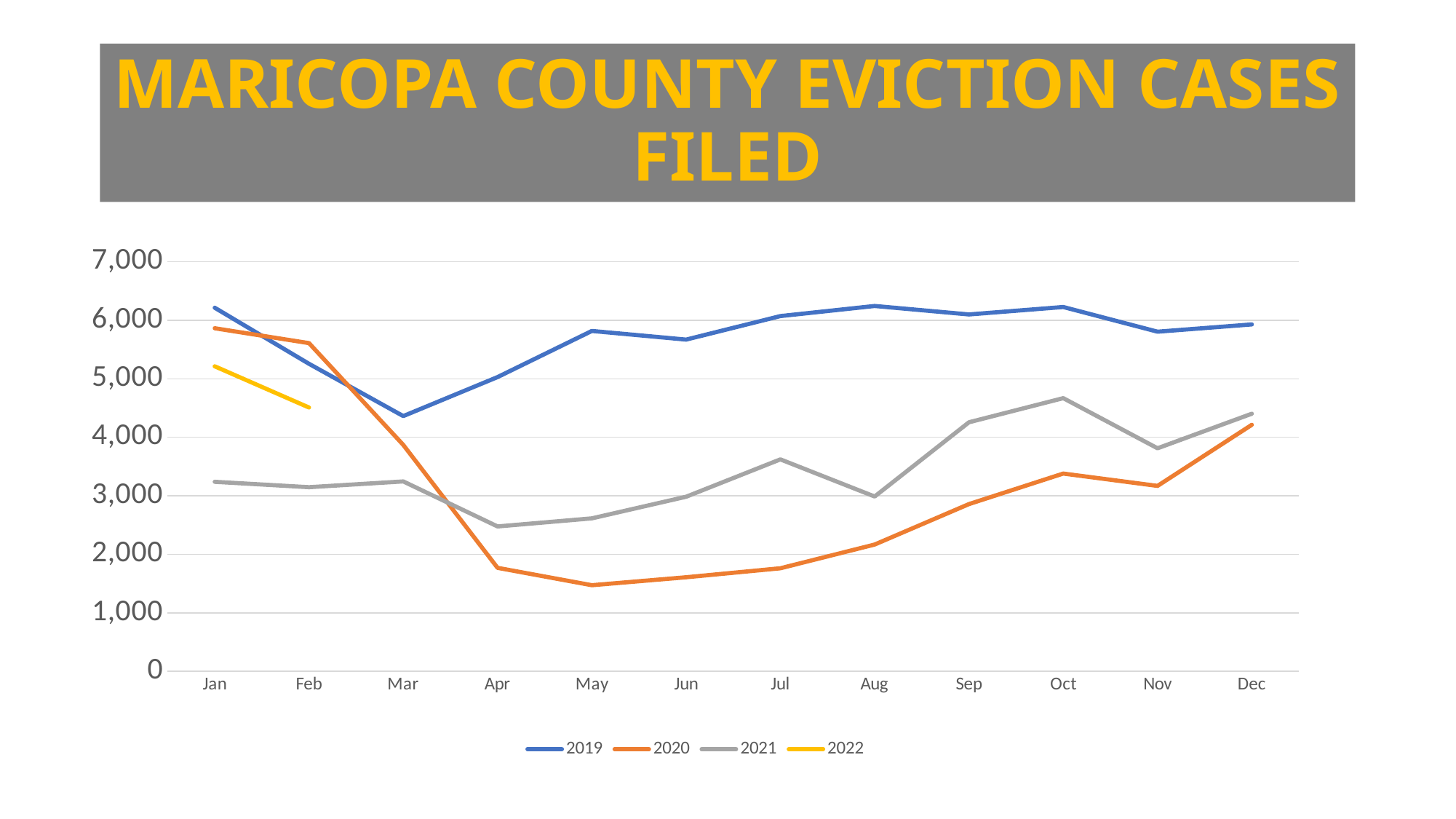
In which month does the 2019 line reach its lowest point? Mar How many months are shown along the x axis? 12 In Oct, which series has the larger value, 2020 or 2021? 2021 Is the value for 2019 in Aug greater or less than 6,000? greater Does the 2022 line rise or fall from Jan to Feb? fall How many series does the legend list? 4 In Jan, which series has the larger value, 2019 or 2021? 2019 In which month does the 2020 line reach its lowest point? May What kind of chart is shown on the slide? line chart Is the value for 2020 in Apr greater or less than 2,000? less In which month does the 2021 line reach its highest point? Oct What is the title of the chart? MARICOPA COUNTY EVICTION CASES FILED